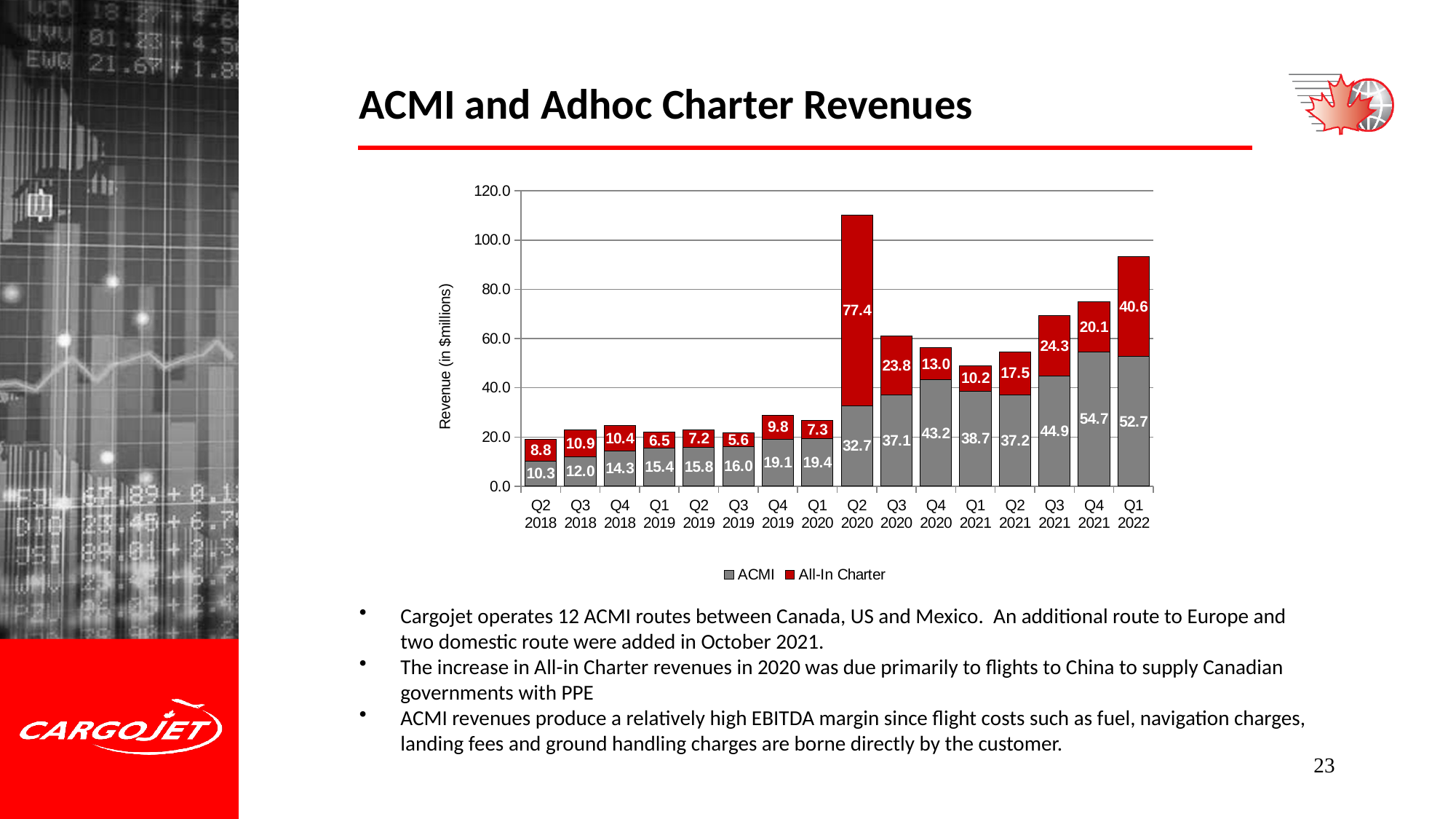
What is the total revenue (ACMI plus All-In Charter) for Q2 2020? 110.1 What is the difference between ACMI revenue in Q4 2021 and Q1 2022? 2.0 What is the label of the y axis? Revenue (in $millions) How many series does the legend list? 2 What was the ACMI revenue in Q2 2020? 32.7 What type of chart is shown on the slide? Stacked bar chart What was the All-In Charter revenue in Q1 2022? 40.6 In which quarter was ACMI revenue lowest? Q2 2018 In which quarter was All-In Charter revenue highest? Q2 2020 Which was larger in Q3 2021: ACMI revenue or All-In Charter revenue? ACMI How many quarters are shown on the x axis? 16 What was the ACMI revenue in Q4 2021? 54.7